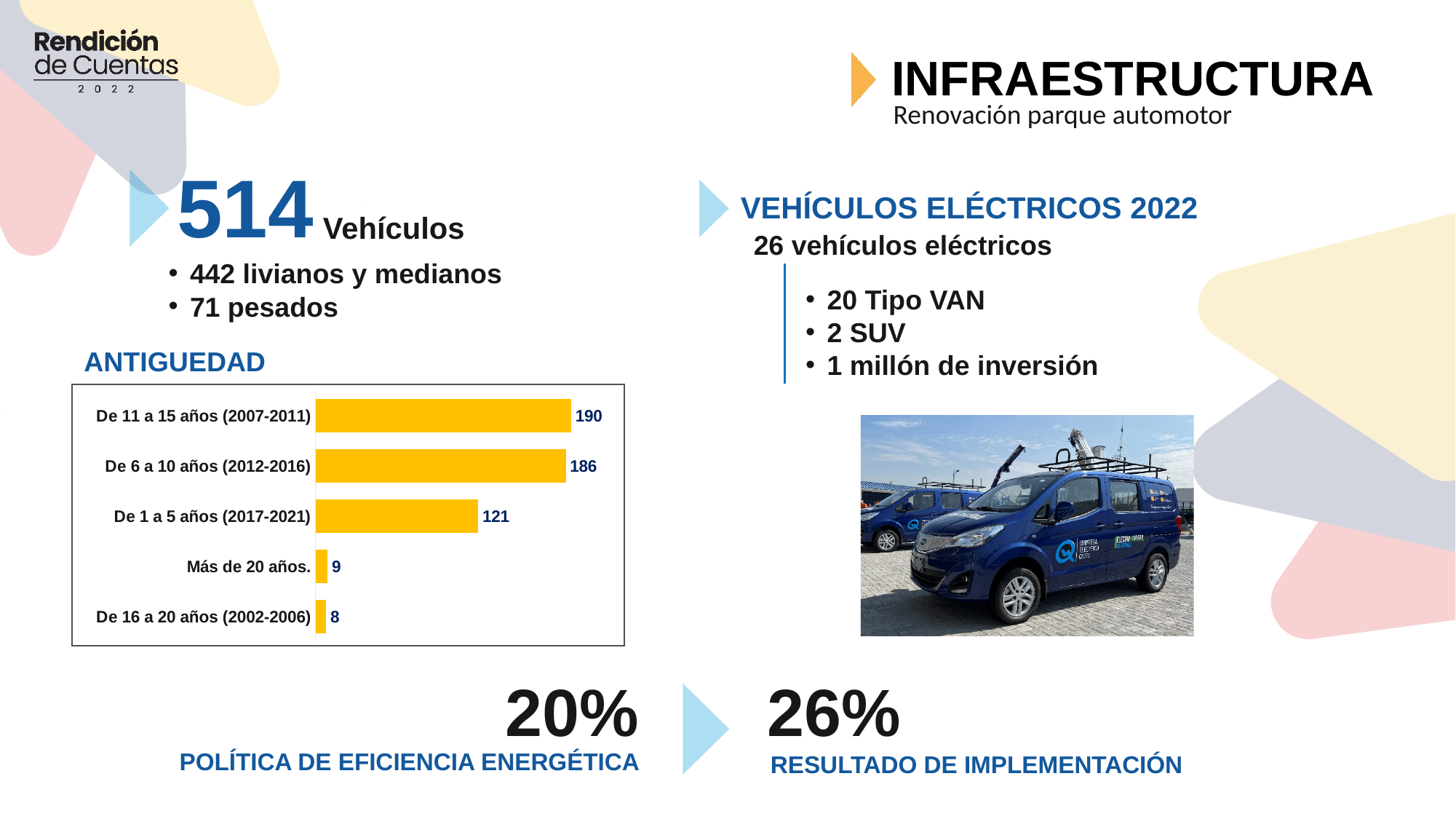
What is the value for 'De 11 a 15 años (2007-2011)' in the ANTIGUEDAD chart? 190 What colour are the bars in the ANTIGUEDAD chart? Yellow What is the value for 'De 1 a 5 años (2017-2021)' in the ANTIGUEDAD chart? 121 Which category has the highest value in the ANTIGUEDAD chart? De 11 a 15 años (2007-2011) Which is larger in the ANTIGUEDAD chart: 'De 1 a 5 años (2017-2021)' or 'Más de 20 años.'? De 1 a 5 años (2017-2021) What is the value for 'De 16 a 20 años (2002-2006)' in the ANTIGUEDAD chart? 8 Which category has the lowest value in the ANTIGUEDAD chart? De 16 a 20 años (2002-2006) What is the difference between the values for 'De 11 a 15 años (2007-2011)' and 'De 6 a 10 años (2012-2016)' in the ANTIGUEDAD chart? 4 How many categories are shown in the ANTIGUEDAD chart? 5 What kind of chart is the ANTIGUEDAD chart? Bar chart What is the value for 'Más de 20 años.' in the ANTIGUEDAD chart? 9 What is the difference between the values for 'De 6 a 10 años (2012-2016)' and 'De 1 a 5 años (2017-2021)' in the ANTIGUEDAD chart? 65